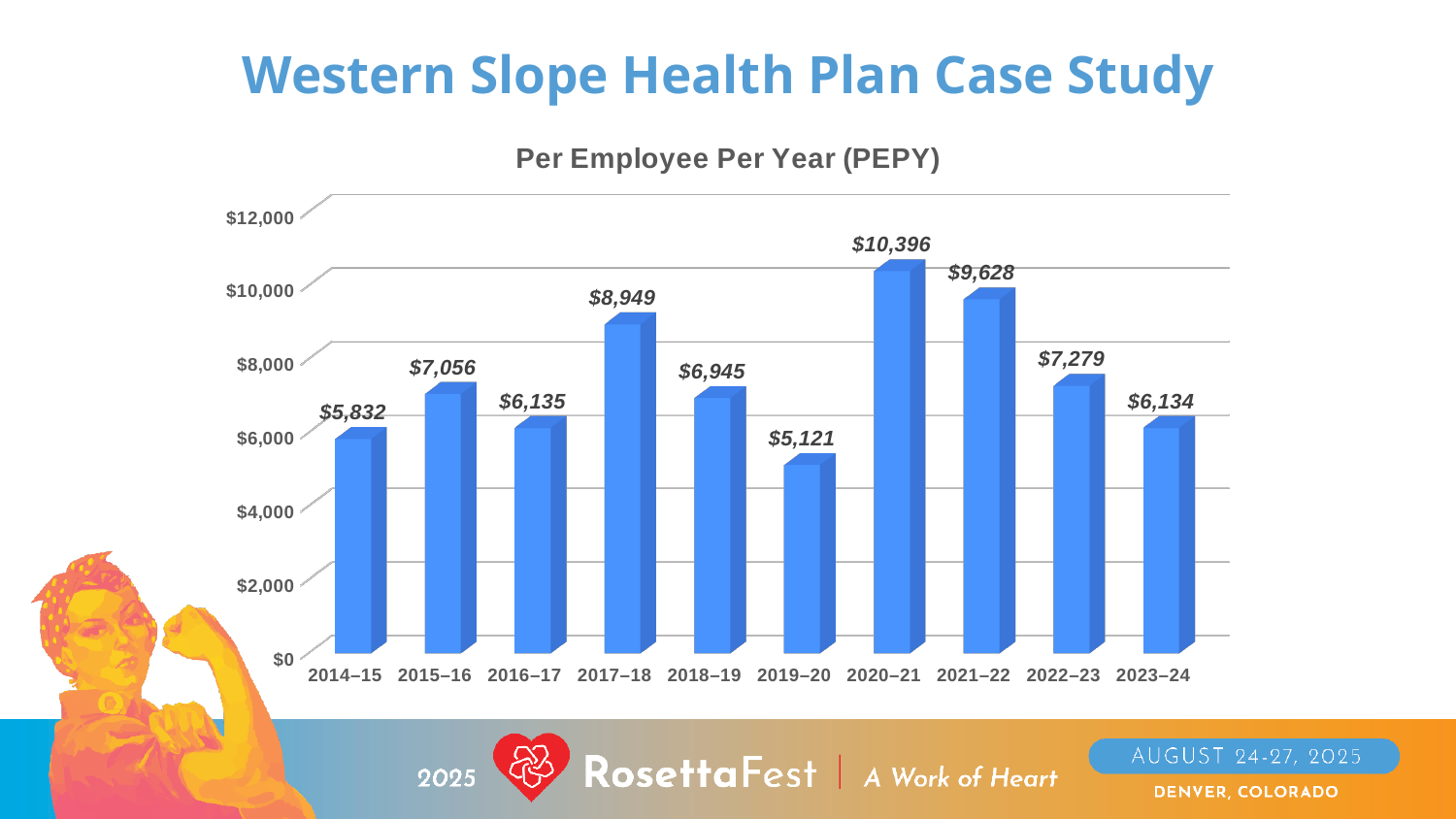
What is the PEPY value for 2023–24? $6,134 What is the difference between the PEPY values for 2020–21 and 2021–22? $768 Which is larger, the PEPY value for 2015–16 or for 2018–19? 2015–16 What is the difference between the PEPY values for 2014–15 and 2015–16? $1,224 What kind of chart is shown on the slide? bar chart Did the PEPY value rise or fall from 2018–19 to 2019–20? fall Which year has the lowest PEPY value? 2019–20 Is the PEPY value for 2022–23 greater or less than $8,000? less Which year has the highest PEPY value? 2020–21 How many years are shown on the x axis? 10 What is the PEPY value for 2017–18? $8,949 What is the title of the chart? Per Employee Per Year (PEPY)